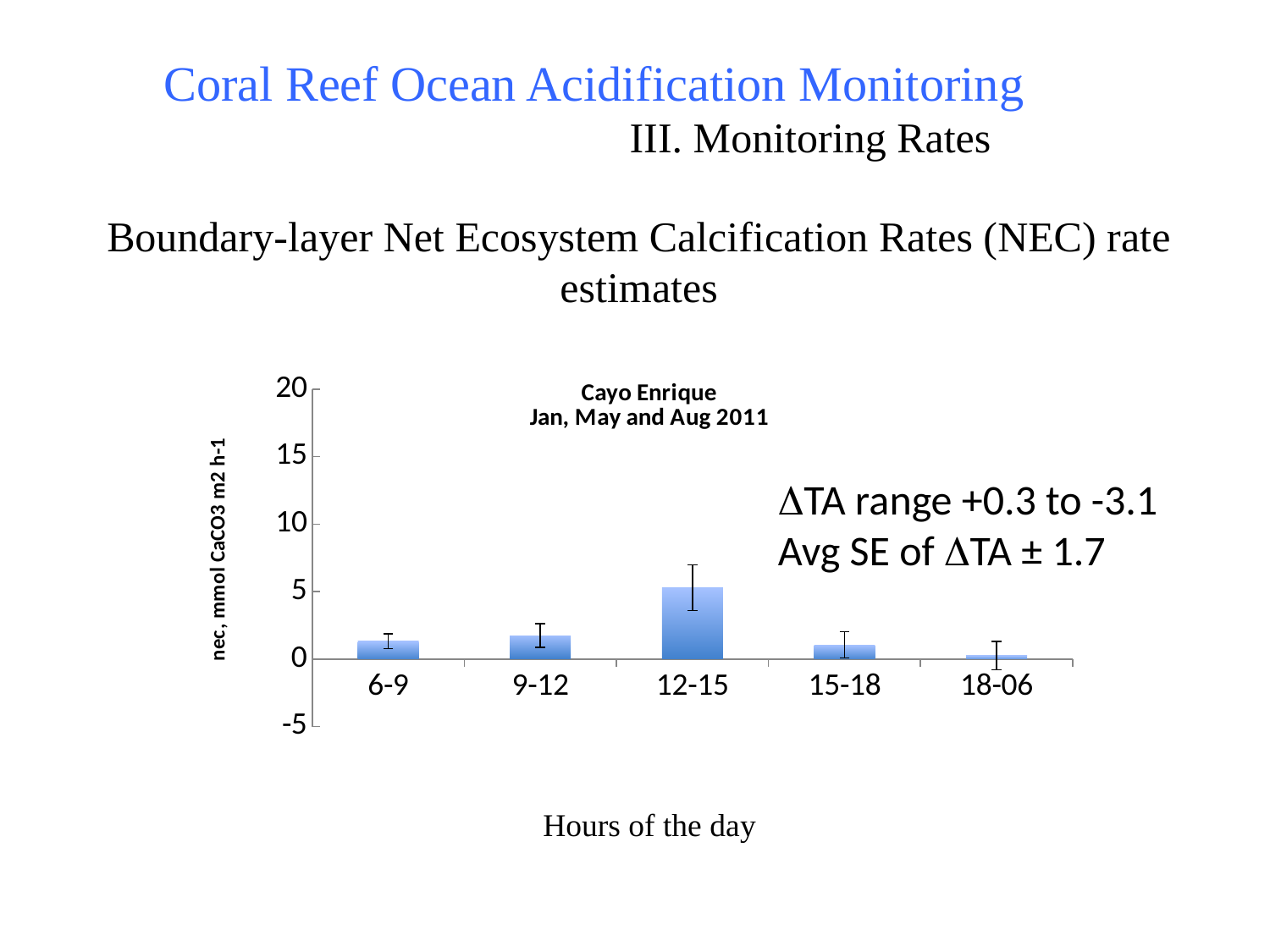
Which has the larger value, 9-12 or 12-15? 12-15 What is the x-axis label of the chart? Hours of the day Is the value for 12-15 greater or less than 10? less Do the values rise or fall from 12-15 to 18-06 along the x axis? fall Is the value for 6-9 greater or less than 5? less What kind of chart is shown on the slide? bar chart How many time-of-day categories are plotted on the x axis? 5 Which has the larger value, 12-15 or 15-18? 12-15 Is the value for 15-18 greater or less than 5? less Which hours-of-the-day category has the lowest NEC value? 18-06 What is the title printed inside the chart? Cayo Enrique Jan, May and Aug 2011 Which hours-of-the-day category has the highest NEC value? 12-15